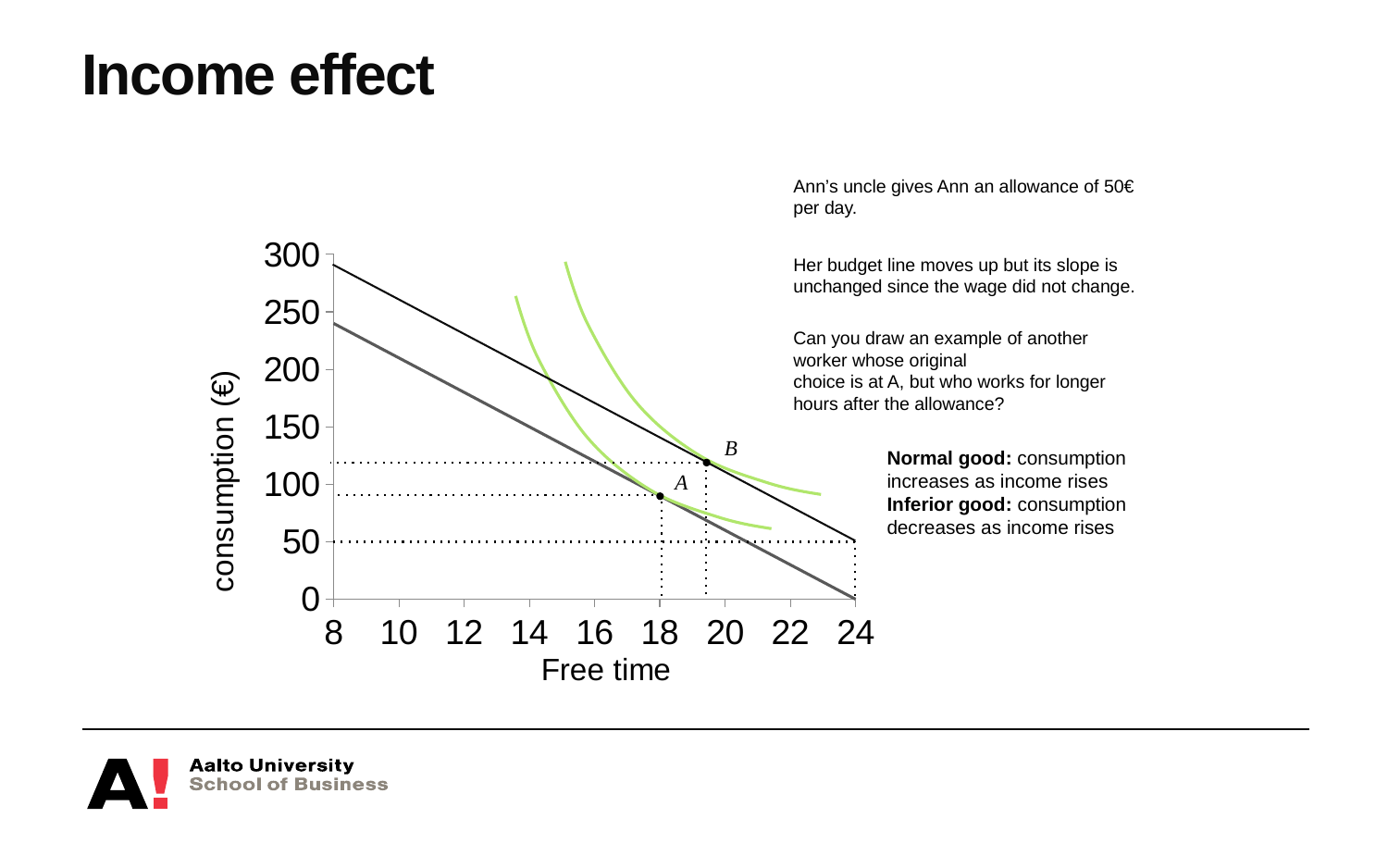
What kind of chart is shown on the slide? line chart Is the consumption at point B greater or less than 150? less What is the consumption value of the upper (black) budget line at a free time of 24? 50 Is the consumption at point B greater or less than 100? greater What is the label of the x axis? Free time At what free time value does the lower (grey) budget line reach a consumption of 0? 24 What is the free time value at point A? 18 Is the consumption at point A greater or less than 100? less How many labelled points are marked on the chart? 2 Do the budget lines rise or fall as free time increases along the x axis? fall What is the label of the y axis? consumption (€) Which point has the higher consumption, A or B? B